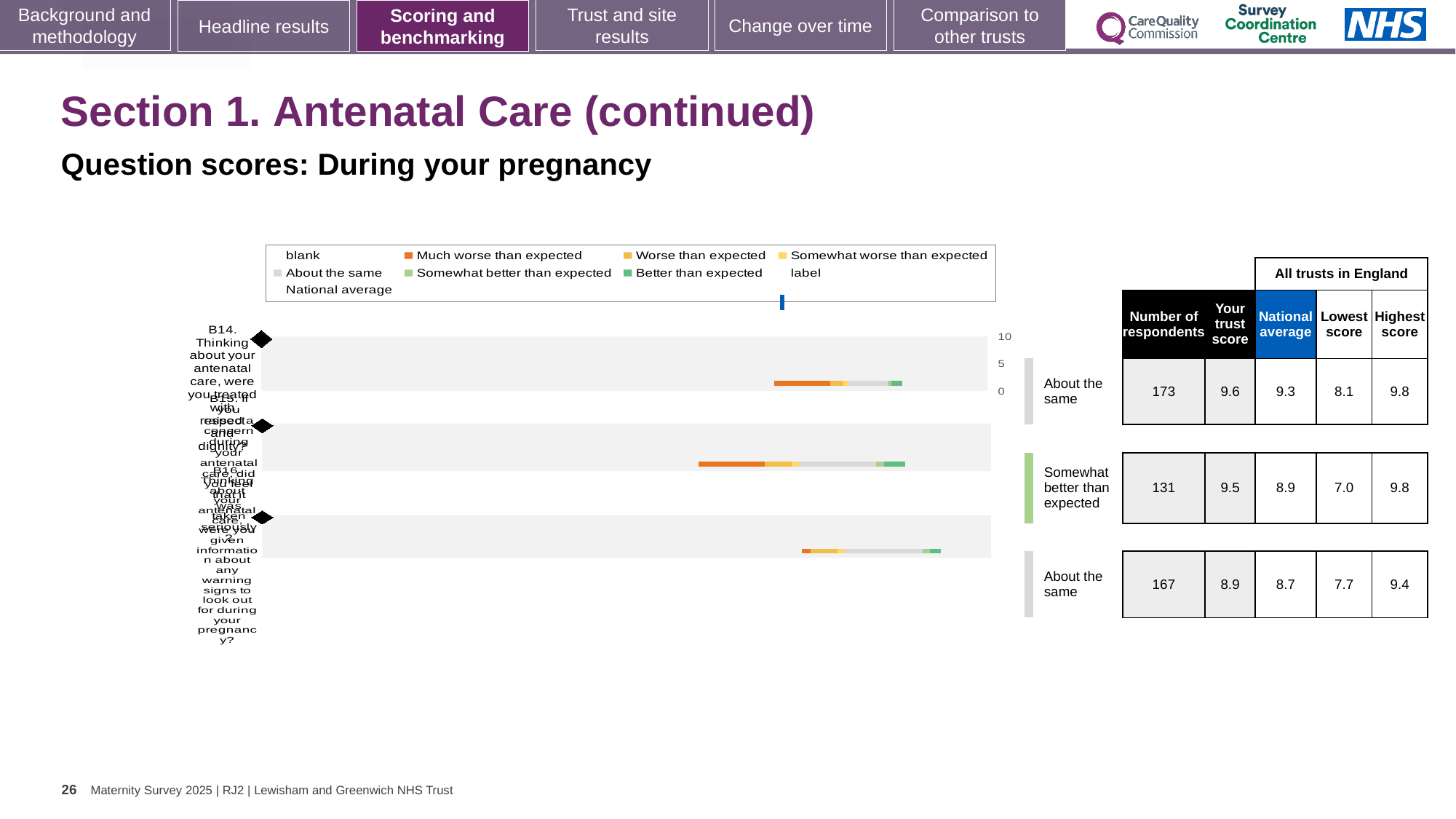
Which of the three questions has the lowest number of respondents? B15 (131) In the table, what is the national average for the second question (B15)? 8.9 What is the highest value shown on the chart's axis? 10 Is the trust score for the first question (B14) larger or smaller than its national average? larger How many questions (bars) are plotted in the chart? 3 In the table, what is the number of respondents for the first question (B14)? 173 What kind of chart is shown on the slide? bar chart Which benchmark category is the second question (B15) assigned to? Somewhat better than expected In the table, what is the lowest score for the third question (B16)? 7.7 What is the difference between the trust score and the national average for the second question (B15)? 0.6 Which of the three questions has the highest trust score in the table? B14 (9.6) In the table, what is the trust score for the first question (B14)? 9.6